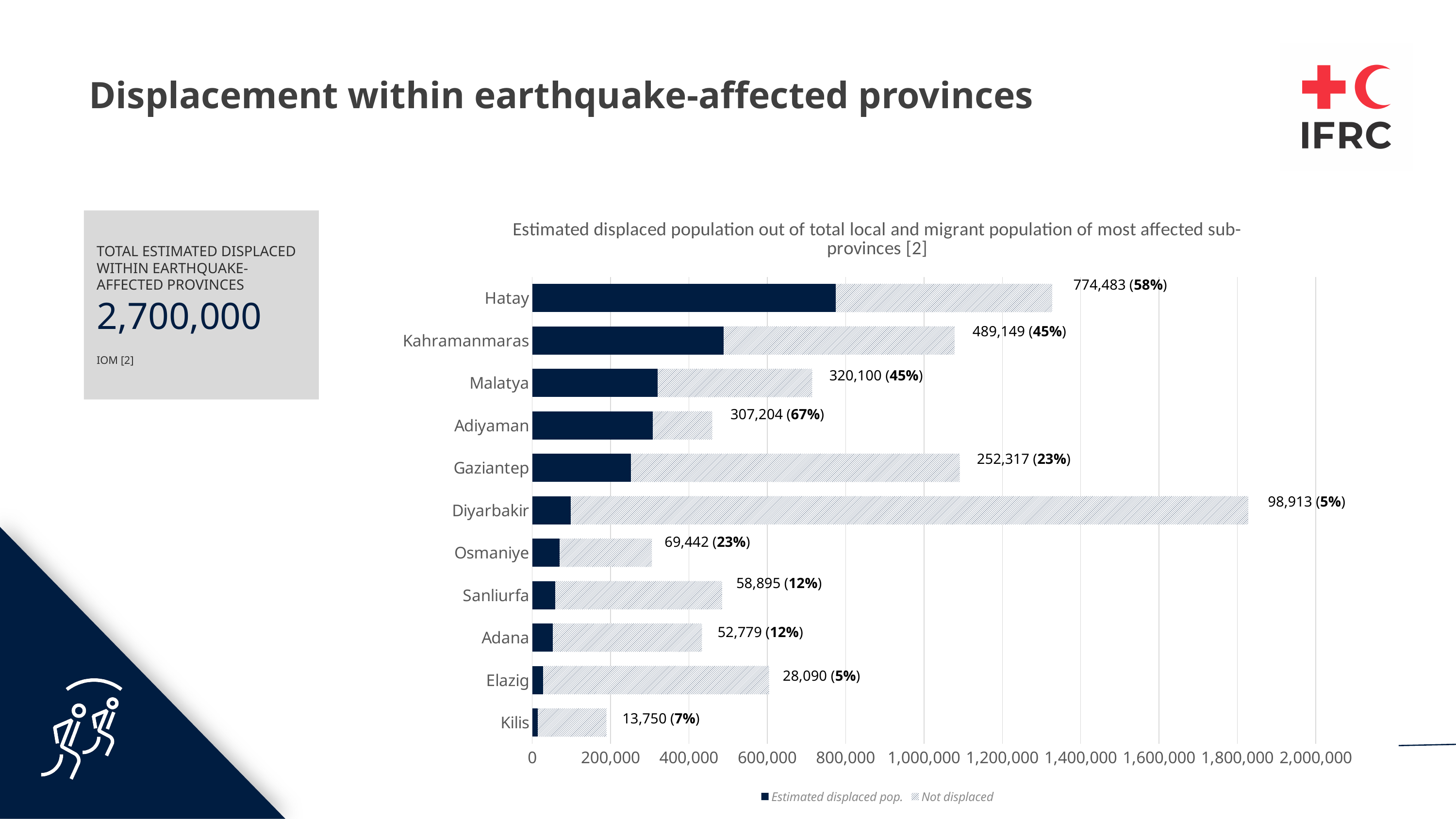
Which province has the lowest estimated displaced population? Kilis What is the difference between the estimated displaced populations of Hatay and Kahramanmaras? 285,334 What percentage of Gaziantep's population is shown as displaced? 23% Which province has the highest estimated displaced population? Hatay How many series does the legend list? 2 What is the estimated displaced population for Hatay? 774,483 What percentage of Adiyaman's population is shown as displaced? 67% Which has a larger estimated displaced population, Malatya or Adiyaman? Malatya How many provinces are shown in the chart? 11 Is the total bar length (displaced plus not displaced) for Diyarbakir greater or less than 1,600,000? greater What kind of chart is shown on the slide? Stacked bar chart Which province has the highest displacement percentage? Adiyaman